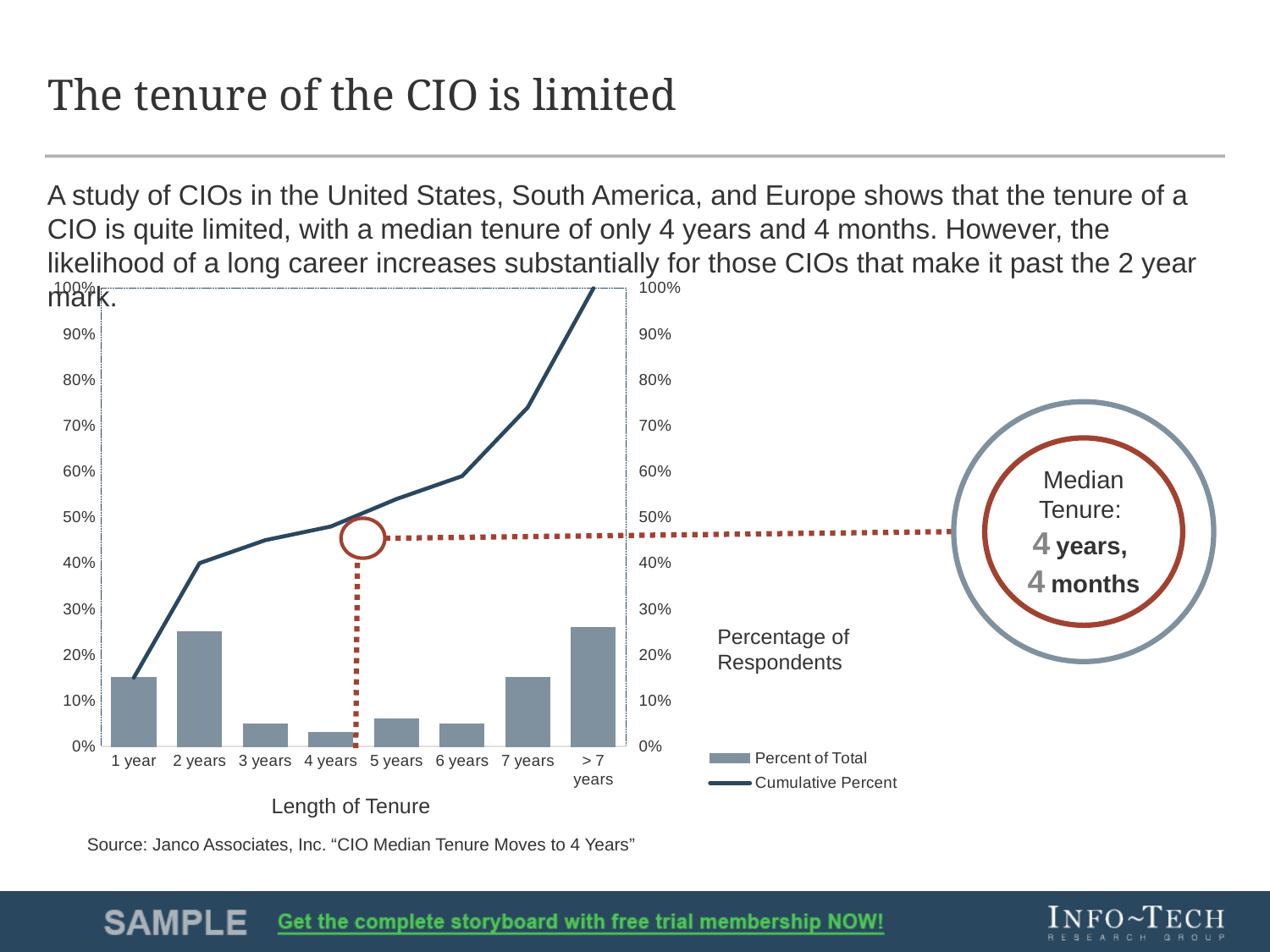
How many tenure categories are shown on the x axis of the chart? 8 What is the Cumulative Percent value at the "> 7 years" category? 100% How many series does the chart's legend list? 2 What kind of chart is shown on the slide? A combined bar and line chart Is the Percent of Total bar for 2 years greater or less than 20%? greater What is the title of the chart's x axis? Length of Tenure Is the Cumulative Percent value at 1 year greater or less than 20%? less Is the Cumulative Percent value at 7 years greater or less than 70%? greater Does the Cumulative Percent line rise or fall as tenure length increases along the x axis? Rises Which series in the legend is drawn as a line? Cumulative Percent Which has the larger Percent of Total bar, 2 years or 3 years? 2 years